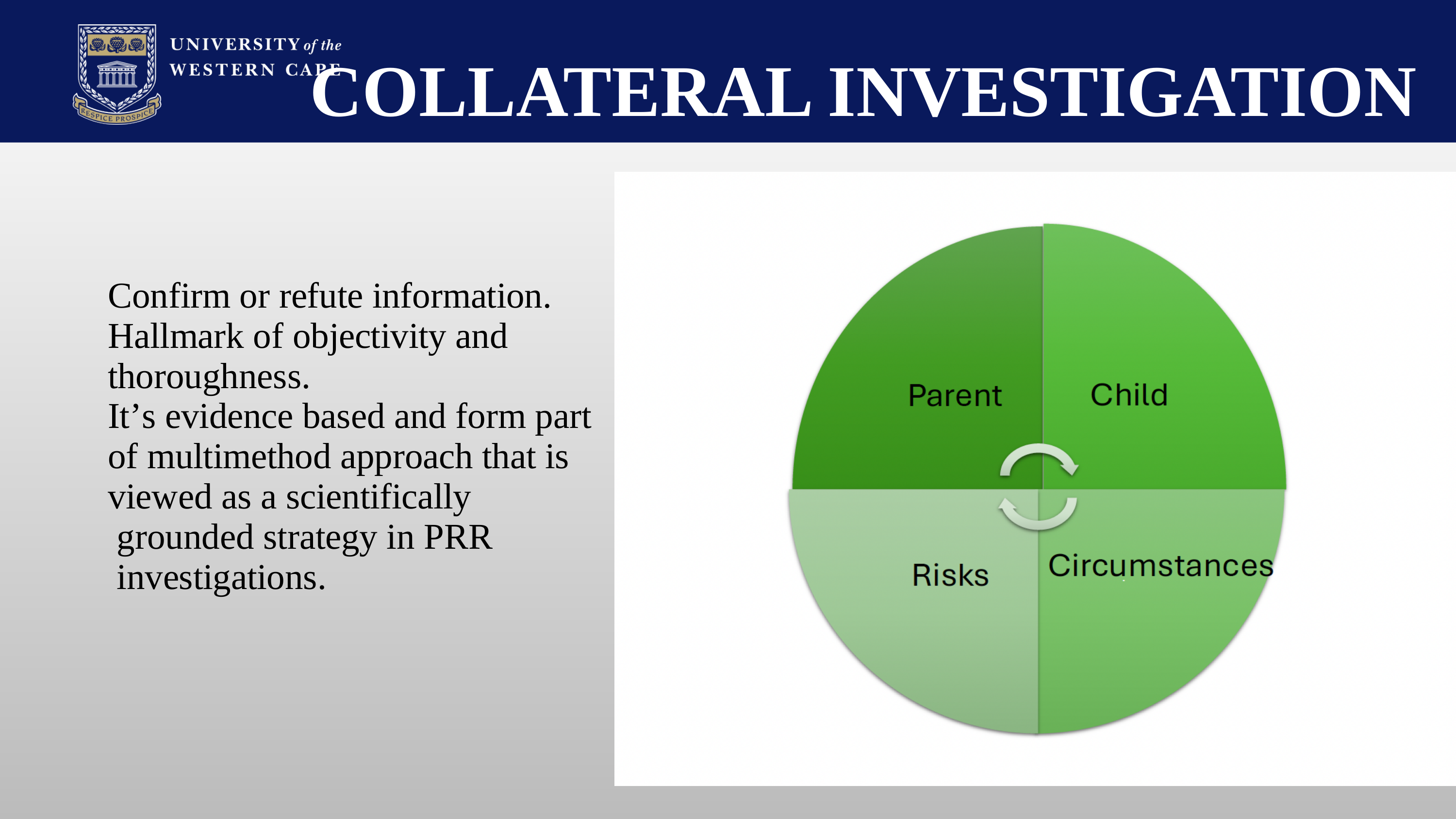
What kind of chart is shown on the right of the slide? pie chart What is the label of the top-left segment of the circular diagram? Parent How many segments does the circular diagram on the right have? 4 Which segment of the circular diagram is labelled 'Child': top-left, top-right, bottom-left or bottom-right? top-right What is the label of the bottom-right segment of the circular diagram? Circumstances Which segment of the circular diagram is labelled 'Risks': top-left, top-right, bottom-left or bottom-right? bottom-left